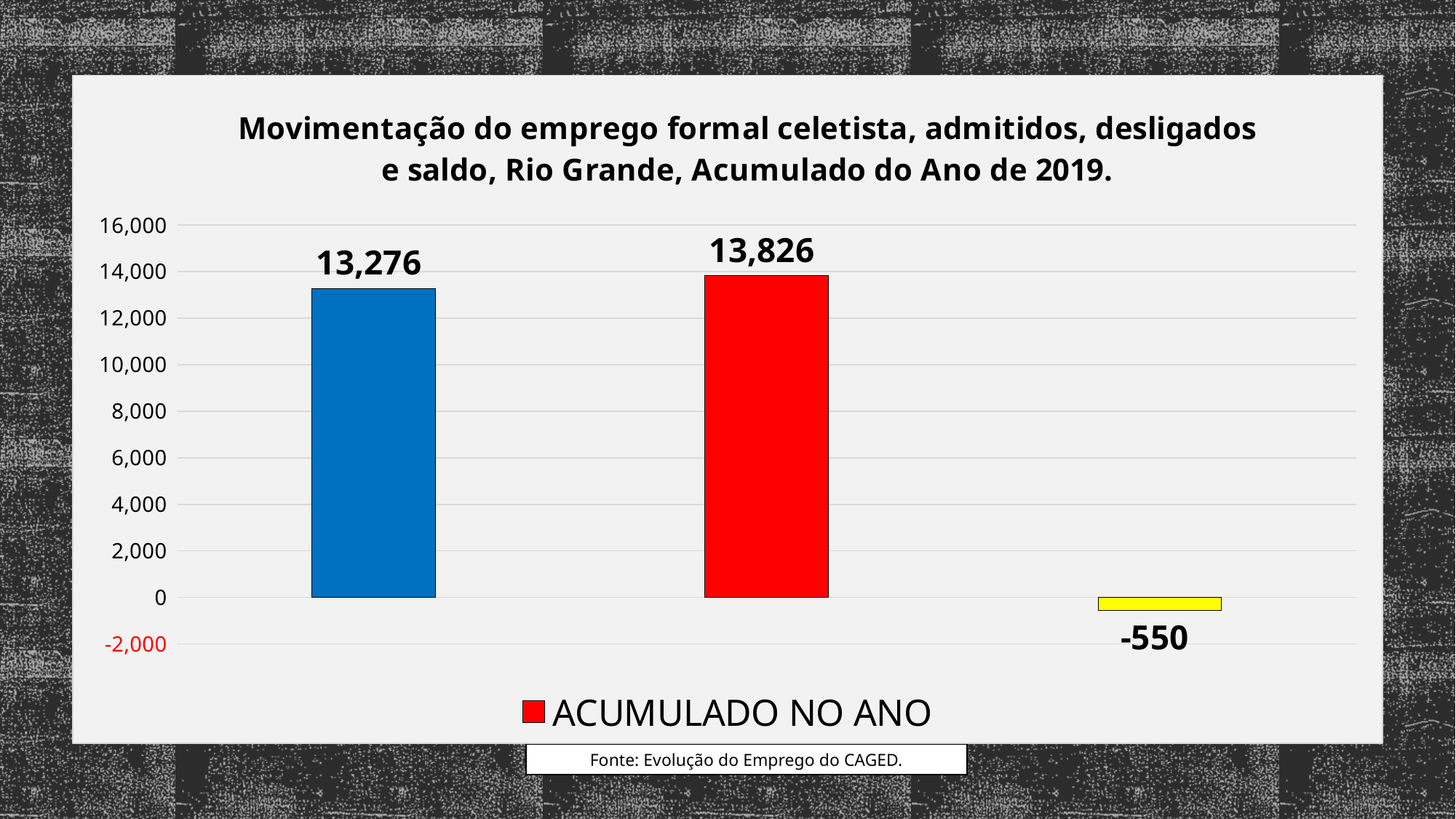
What is the legend entry shown below the chart? ACUMULADO NO ANO Which is larger, the value of the blue bar or the value of the red bar? The red bar What kind of chart is shown on the slide? Bar chart What value is shown on the blue bar? 13,276 What is the difference between the red bar's value and the blue bar's value? 550 How many bars are plotted in the chart? 3 What value is shown on the red bar? 13,826 Is the value of the blue bar greater or less than 12,000? greater Which bar has the lowest value? The yellow bar (-550) What value is shown on the yellow bar? -550 What is the source cited below the chart? Fonte: Evolução do Emprego do CAGED. Which bar has the highest value? The red bar (13,826)